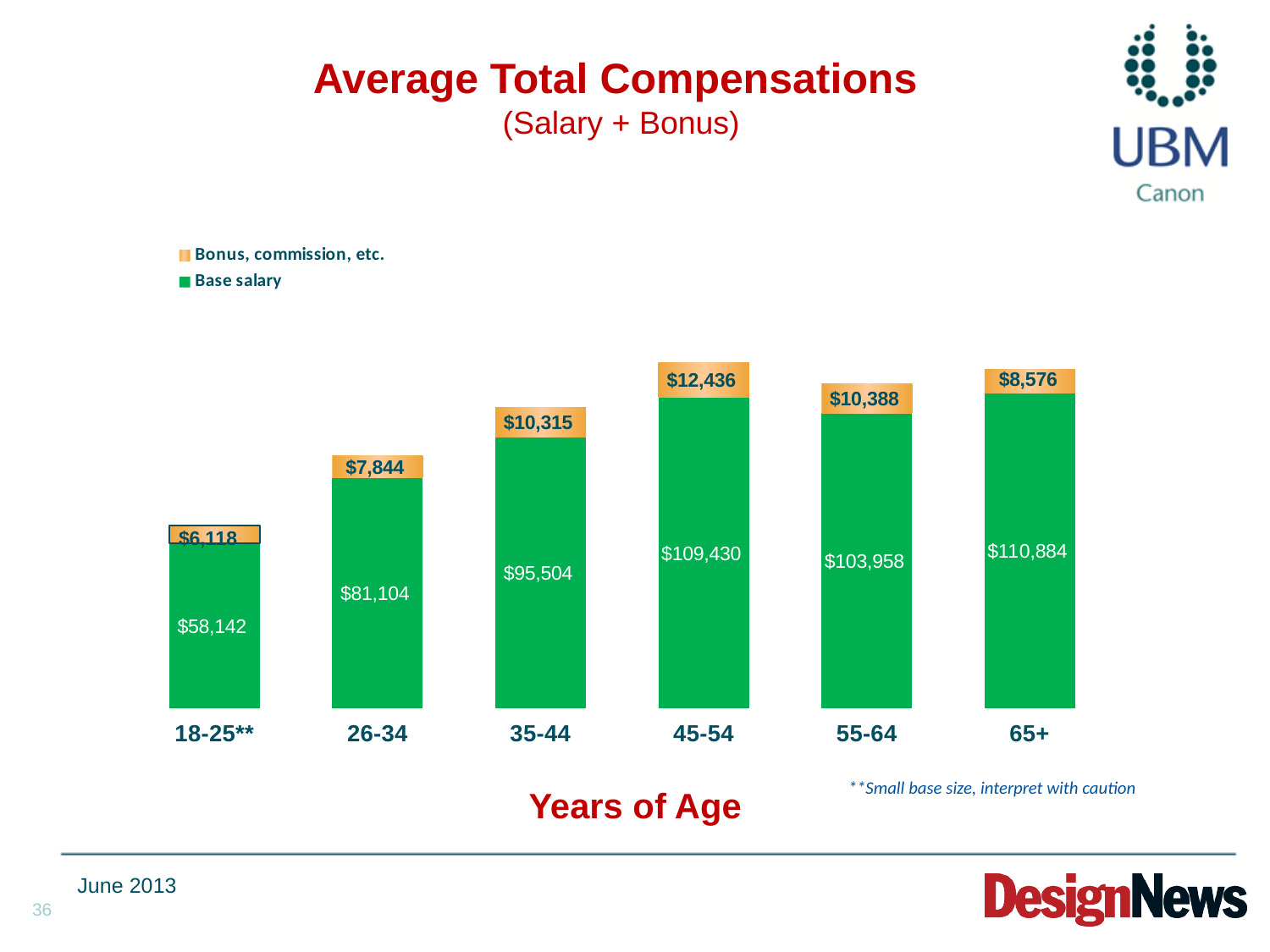
What is the total compensation (base salary plus bonus) for the 45-54 age group? $121,866 What is the difference in base salary between the 26-34 and 18-25** age groups? $22,962 Which age group has the lowest base salary? 18-25** Which is larger, the base salary for 55-64 or for 45-54? 45-54 What is the base salary for the 35-44 age group? $95,504 What is the base salary for the 65+ age group? $110,884 What is the bonus, commission, etc. value for the 45-54 age group? $12,436 What type of chart is shown on the slide? Stacked bar chart How many series does the legend list? 2 Which age group has the highest bonus, commission, etc. value? 45-54 How many age groups are shown on the chart? 6 What is the total compensation (base salary plus bonus) for the 26-34 age group? $88,948